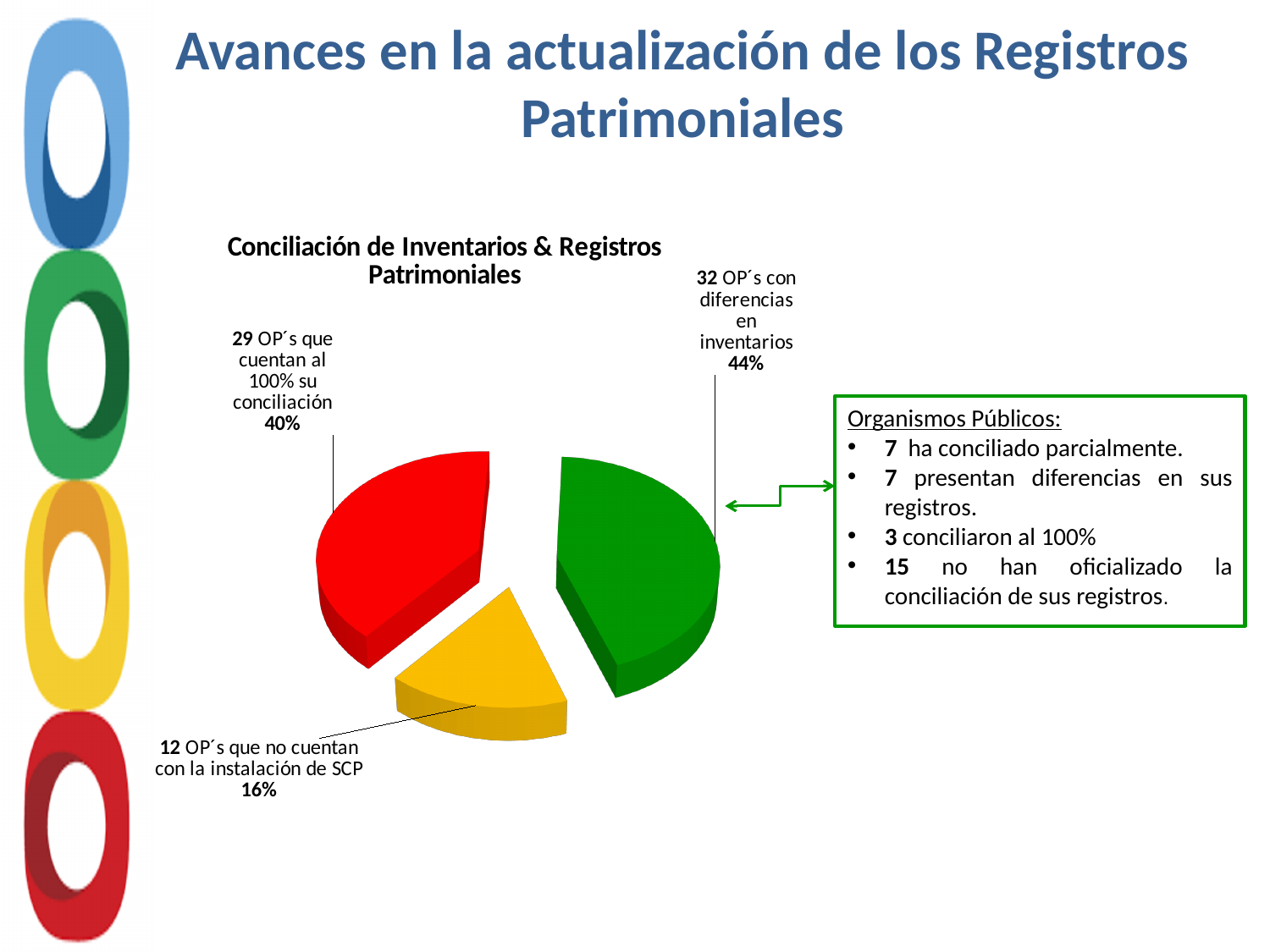
How many OP's do not have the SCP installed (no cuentan con la instalación de SCP)? 12 What percentage of the pie corresponds to OP's que cuentan al 100% su conciliación? 40% How many OP's have differences in inventories (con diferencias en inventarios)? 32 Which category has the largest share of the pie? OP's con diferencias en inventarios What is the title of the pie chart? Conciliación de Inventarios & Registros Patrimoniales What percentage of the pie corresponds to OP's con diferencias en inventarios? 44% Which colour represents the OP's que no cuentan con la instalación de SCP slice? Yellow How many slices does the pie chart have? 3 What kind of chart is shown on the slide? Pie chart Which category has the smallest share of the pie? OP's que no cuentan con la instalación de SCP What percentage of the pie corresponds to OP's que no cuentan con la instalación de SCP? 16% What is the difference in number of OP's between those with differences in inventories and those that have 100% conciliation? 3